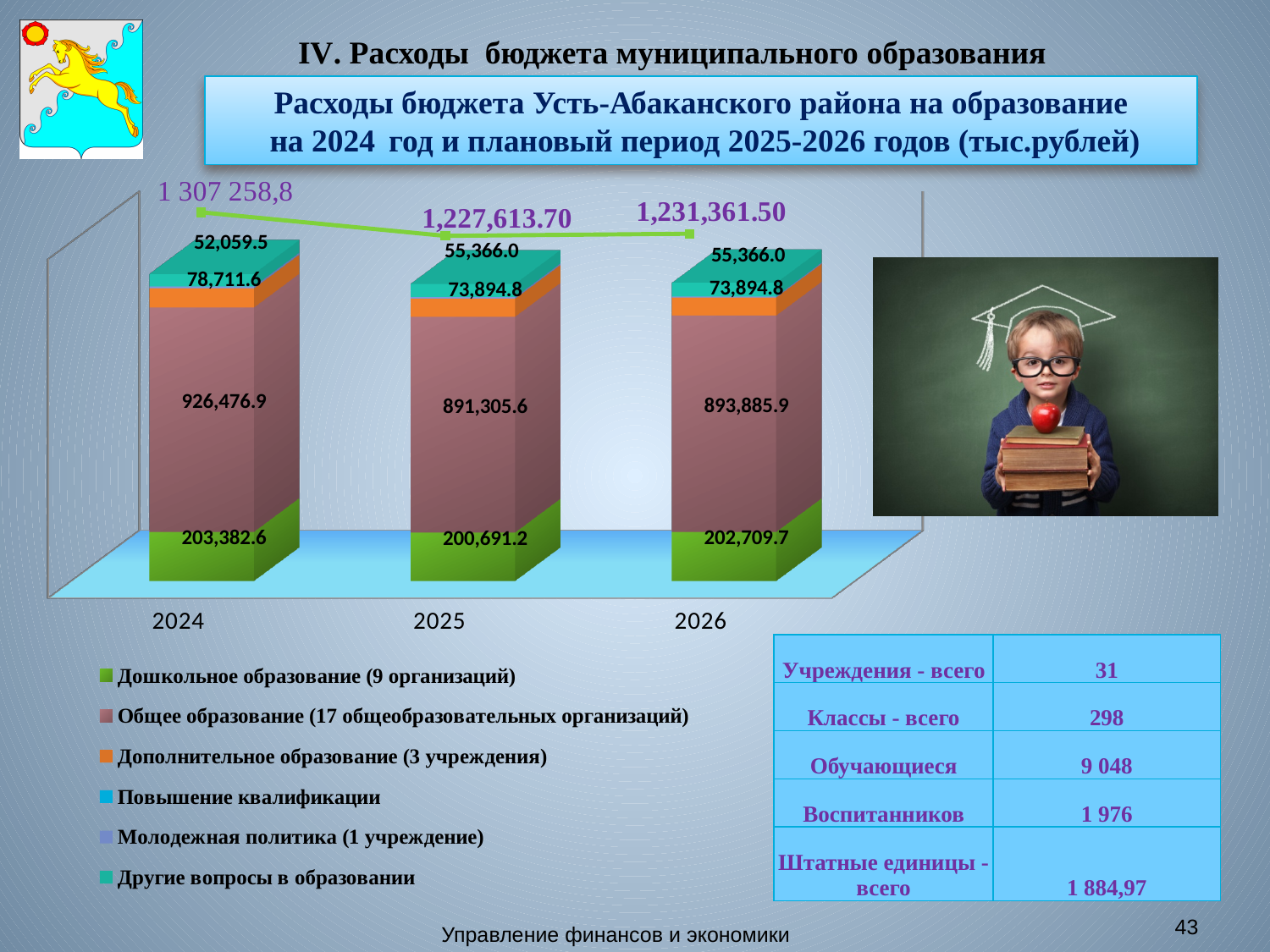
How many series does the chart legend list? 6 What is the value of the Дошкольное образование segment for 2024? 203,382.6 What total is shown above the bar for 2025? 1,227,613.70 What is the value of the Общее образование segment for 2026? 893,885.9 What type of chart is shown on the slide? stacked bar chart How many years (categories) are shown on the x axis of the chart? 3 What total is shown above the bar for 2026? 1,231,361.50 Which year has the largest Общее образование segment? 2024 What is the value of the Общее образование segment for 2025? 891,305.6 What is the value of the Дошкольное образование segment for 2026? 202,709.7 Which is larger, the Общее образование value for 2025 or for 2026? 2026 Which year has the smallest Дошкольное образование segment? 2025